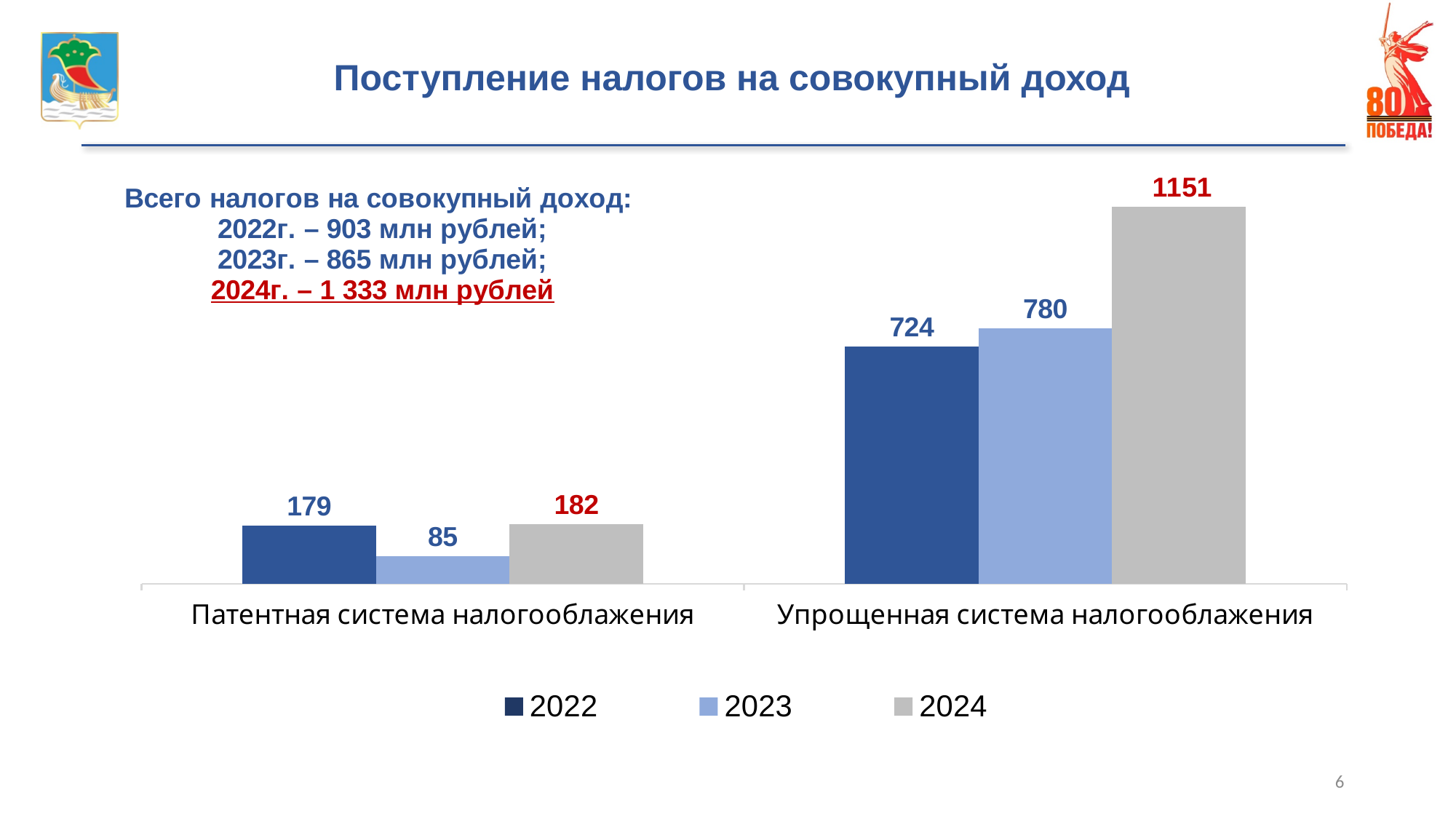
What is the difference between the 2022 and 2023 values in the Патентная система налогооблажения category? 94 How many series does the legend list? 3 What is the value for 2022 in the Упрощенная система налогооблажения category? 724 What is the value for 2023 in the Патентная система налогооблажения category? 85 What kind of chart is shown on the slide? Bar chart Which year has the highest value in the Упрощенная система налогооблажения category? 2024 Which is larger: the 2024 value for Патентная система налогооблажения or the 2022 value for Упрощенная система налогооблажения? 2022 value for Упрощенная система налогооблажения How many categories are shown on the x axis? 2 What is the value for 2024 in the Упрощенная система налогооблажения category? 1151 Which year has the lowest value in the Патентная система налогооблажения category? 2023 What is the value for 2022 in the Патентная система налогооблажения category? 179 What is the difference between the 2024 and 2023 values in the Упрощенная система налогооблажения category? 371